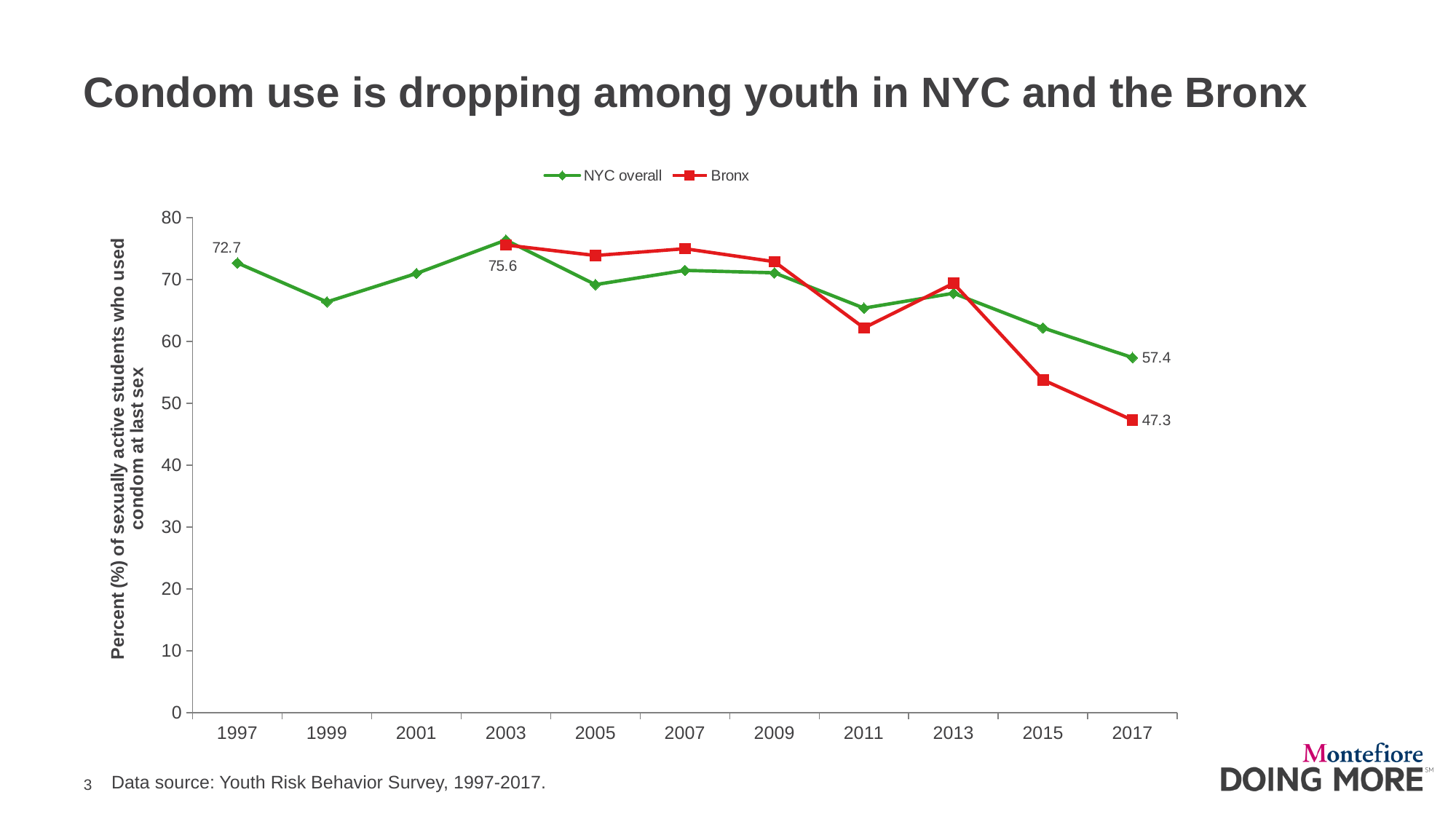
By how much did the NYC overall value fall from 1997 to 2017? 15.3 Is the value for Bronx in 2015 greater or less than 60? less Is the value for NYC overall in 1999 greater or less than 70? less In 2017, which series has the higher value, NYC overall or Bronx? NYC overall How many series does the legend list? 2 What is the value for NYC overall in 1997? 72.7 What kind of chart is shown on the slide? line chart How many years are shown on the x axis? 11 What is the value for Bronx in 2017? 47.3 What is the value for NYC overall in 2017? 57.4 What is the difference between the NYC overall and Bronx values in 2017? 10.1 What is the value for Bronx in 2003? 75.6